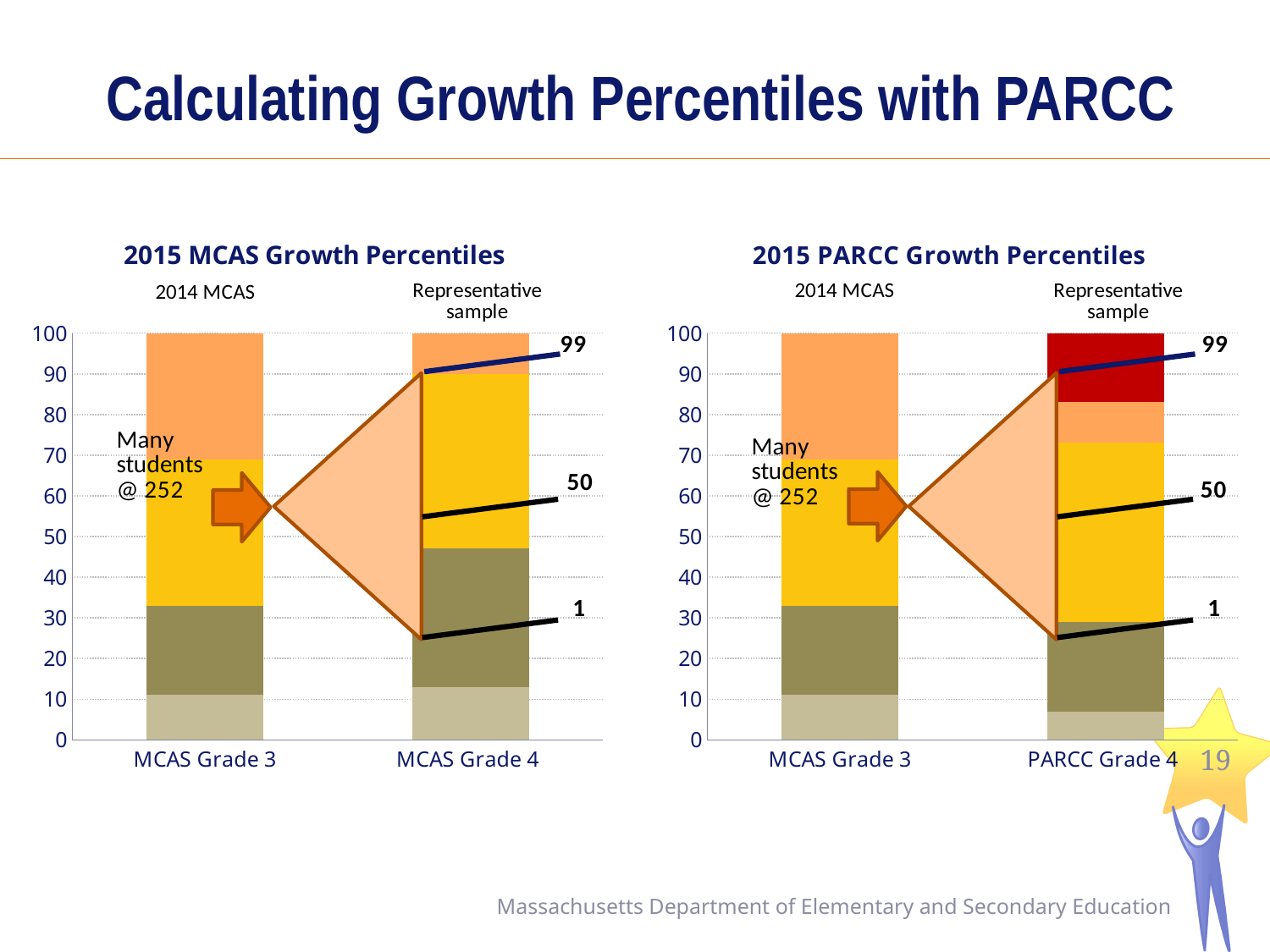
What are the two x-axis categories in the 2015 PARCC Growth Percentiles chart? MCAS Grade 3 and PARCC Grade 4 What is the highest value on the y axis of the 2015 MCAS Growth Percentiles chart? 100 In the 2015 PARCC Growth Percentiles chart, is the top of the lightest bottom segment in the PARCC Grade 4 bar greater or less than 10? less What kind of chart is the 2015 MCAS Growth Percentiles chart? Stacked bar chart In the 2015 MCAS Growth Percentiles chart, is the top of the dark grey segment in the MCAS Grade 4 bar greater or less than 50? less In the 2015 PARCC Growth Percentiles chart, what is the total height of the PARCC Grade 4 stacked bar? 100 In the 2015 MCAS Growth Percentiles chart, what is the total height of the MCAS Grade 3 stacked bar? 100 In the 2015 MCAS Growth Percentiles chart, is the top of the dark grey segment in the MCAS Grade 3 bar greater or less than 30? greater How many categories are shown on the x axis of the 2015 PARCC Growth Percentiles chart? 2 What three percentile values are labelled to the right of the MCAS Grade 4 bar in the 2015 MCAS Growth Percentiles chart? 99, 50 and 1